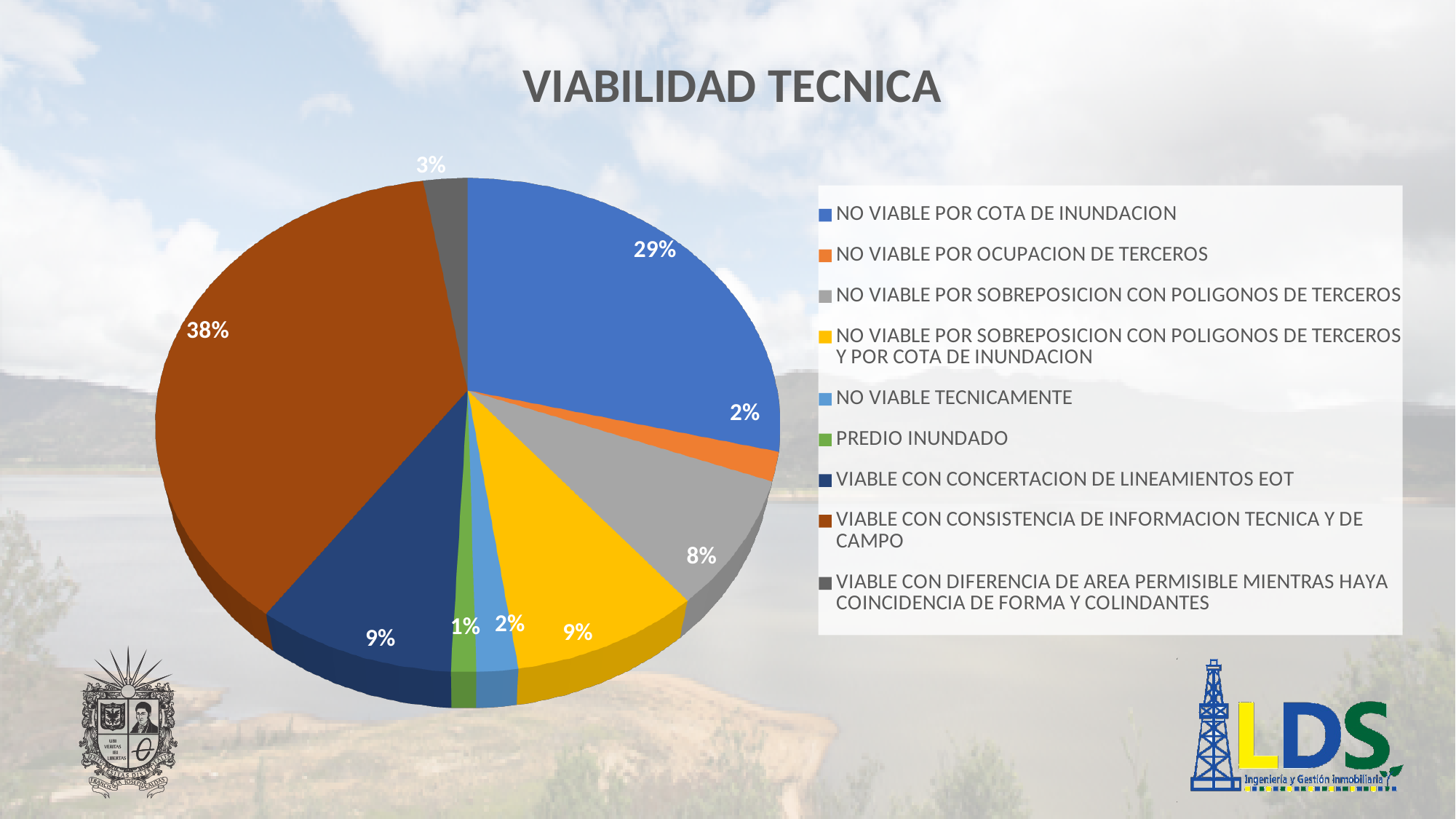
Which category has the largest share of the pie? VIABLE CON CONSISTENCIA DE INFORMACION TECNICA Y DE CAMPO What share of the pie is PREDIO INUNDADO? 1% What is the difference in percentage points between VIABLE CON CONSISTENCIA DE INFORMACION TECNICA Y DE CAMPO and NO VIABLE POR COTA DE INUNDACION? 9 What share of the pie is VIABLE CON CONSISTENCIA DE INFORMACION TECNICA Y DE CAMPO? 38% How many categories does the legend list? 9 Which category has the smallest share of the pie? PREDIO INUNDADO What is the title of the chart? VIABILIDAD TECNICA Which is larger, the share for NO VIABLE POR SOBREPOSICION CON POLIGONOS DE TERCEROS or the share for VIABLE CON CONCERTACION DE LINEAMIENTOS EOT? VIABLE CON CONCERTACION DE LINEAMIENTOS EOT What share of the pie is NO VIABLE POR SOBREPOSICION CON POLIGONOS DE TERCEROS? 8% What type of chart is shown on the slide? Pie chart